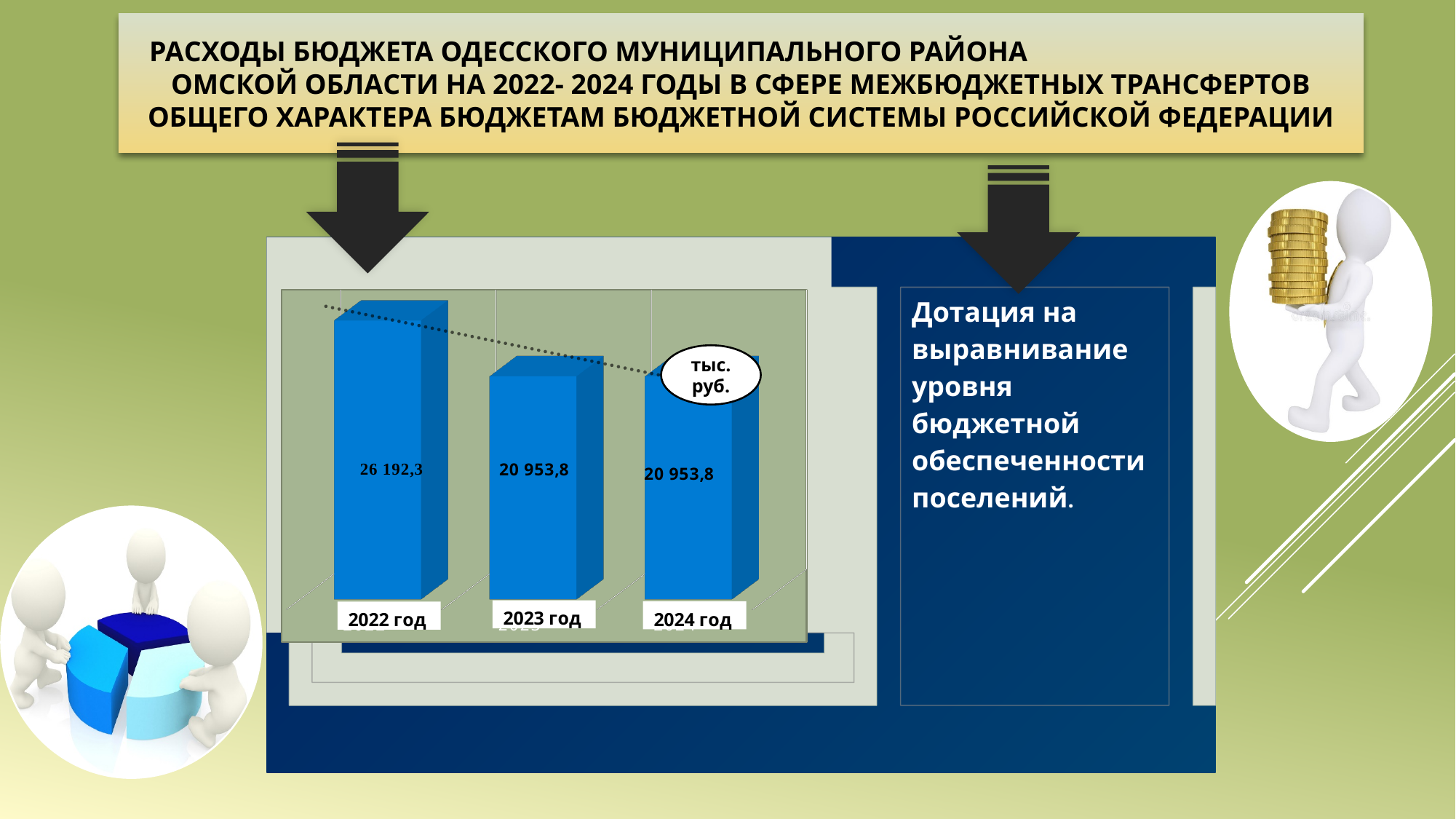
Which year has the highest value? 2022 год What kind of chart is shown on the slide? bar chart Which is larger, the value for 2022 год or the value for 2024 год? 2022 год In what units are the chart values given, according to the label on the chart? тыс. руб. What is the value for 2023 год? 20 953,8 What colour are the bars in the chart? blue What is the value for 2024 год? 20 953,8 What is the difference between the values for 2022 год and 2023 год? 5 238,5 How many years are shown in the chart? 3 What is the value for 2022 год? 26 192,3 Do the values rise or fall from 2022 год to 2024 год? fall